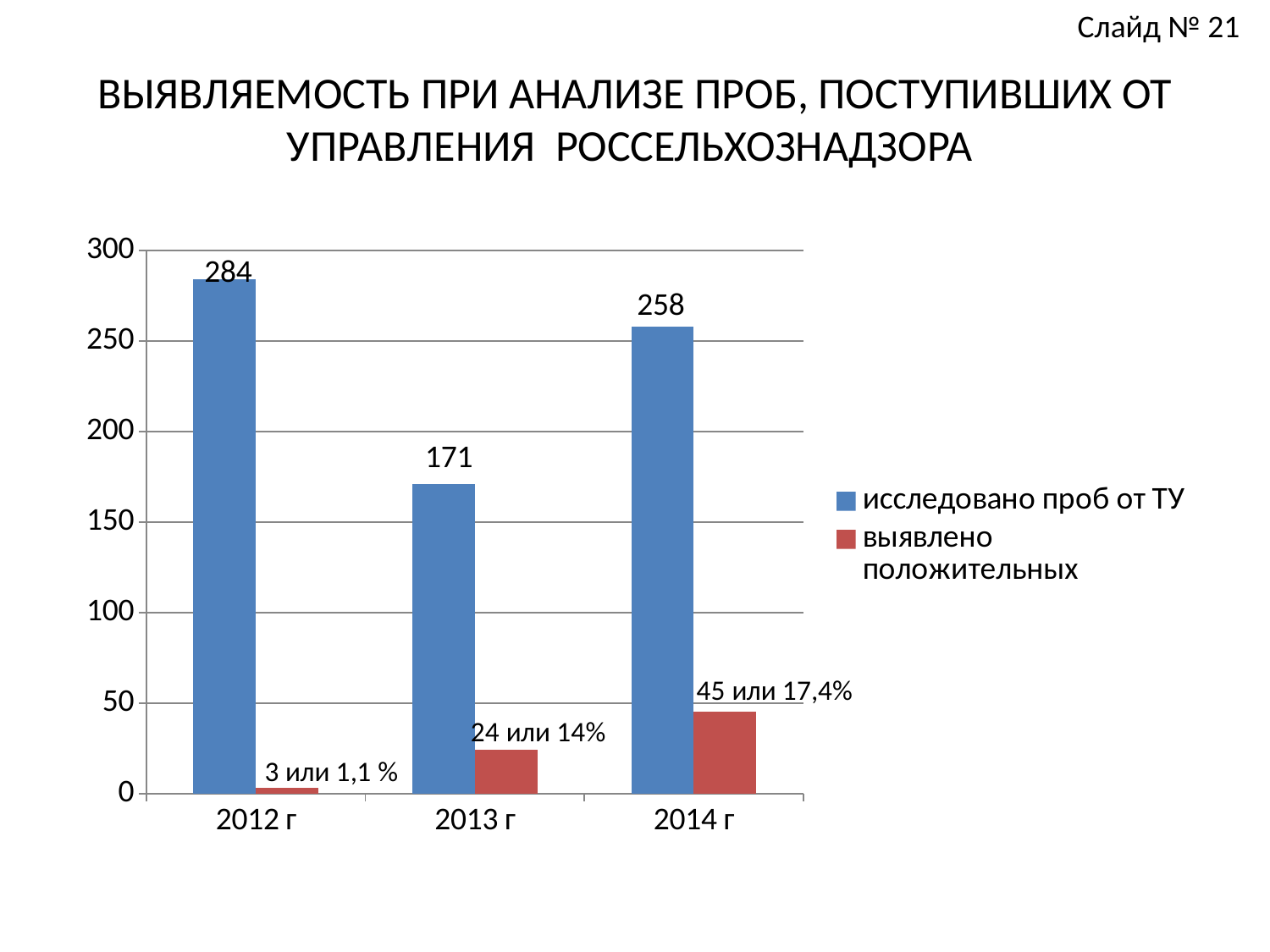
What is the data label on the 'выявлено положительных' bar for 2012 г? 3 или 1,1 % Which year has the highest value for 'исследовано проб от ТУ'? 2012 г What kind of chart is shown on the slide? bar chart Which is larger: 'исследовано проб от ТУ' for 2013 г or for 2014 г? 2014 г What is the data label on the 'выявлено положительных' bar for 2014 г? 45 или 17,4% What is the difference between the 'исследовано проб от ТУ' values for 2012 г and 2014 г? 26 What is the value of 'исследовано проб от ТУ' for 2012 г? 284 How many years are shown on the x axis? 3 How many series does the legend list? 2 What is the value of 'исследовано проб от ТУ' for 2013 г? 171 Which year has the lowest value for 'выявлено положительных'? 2012 г What colour are the 'выявлено положительных' bars? red